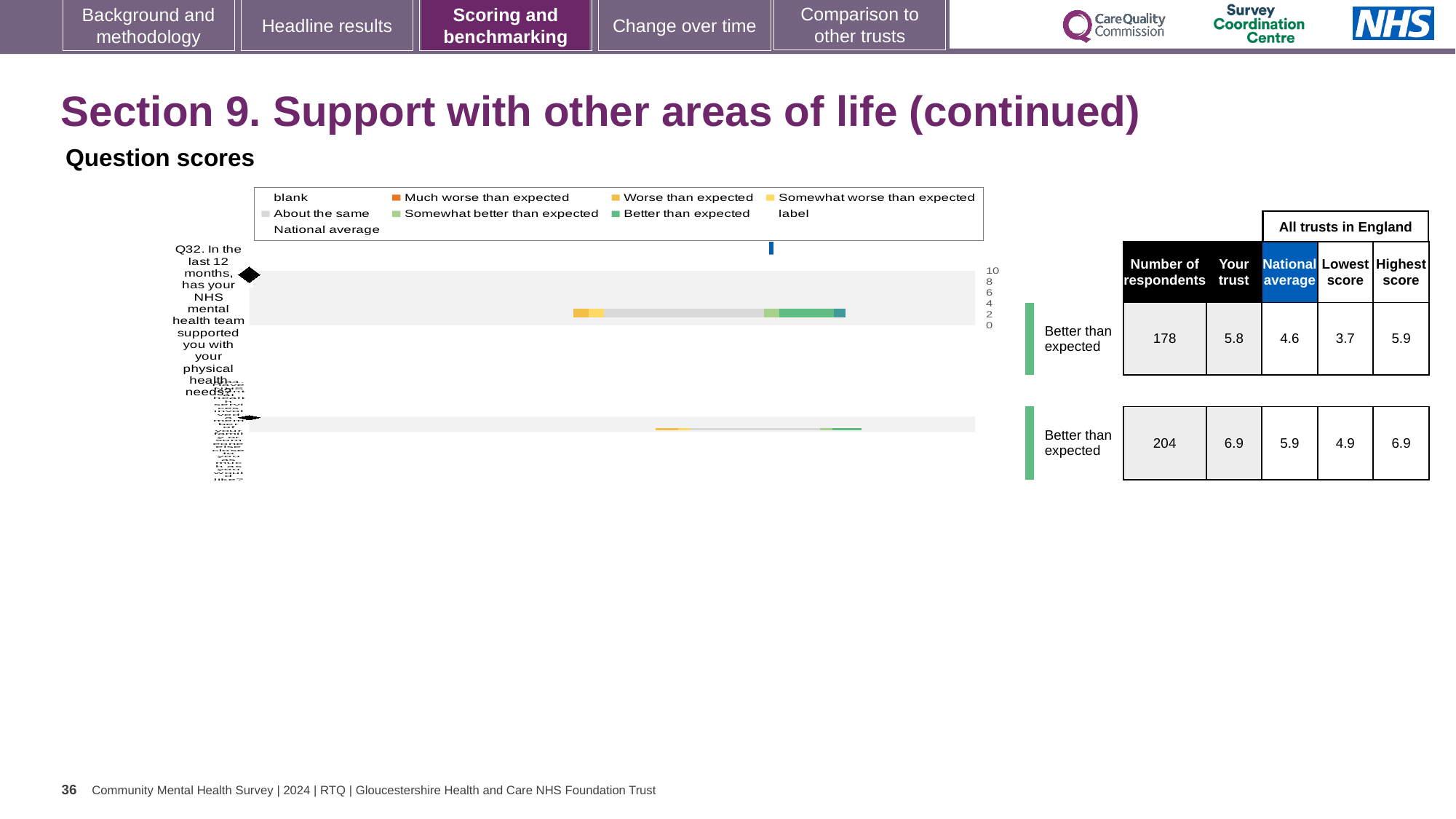
How many question bars are plotted in the chart? 2 How many respondents answered Q32? 178 What benchmark category is shown for Q32? Better than expected What is the national average score for Q32? 4.6 What is the highest score among all trusts in England for Q32? 5.9 What is the lowest score among all trusts in England for Q32? 3.7 Which question had more respondents, Q32 or the second (lower) question? the second (lower) question What kind of chart is shown on the slide? bar chart By how much does the trust's score for Q32 exceed the national average? 1.2 What is the difference between the highest and lowest scores for the second (lower) question? 2.0 What is the 'Your trust' score for the second (lower) question bar? 6.9 What is the 'Your trust' score for Q32 (support with physical health needs)? 5.8